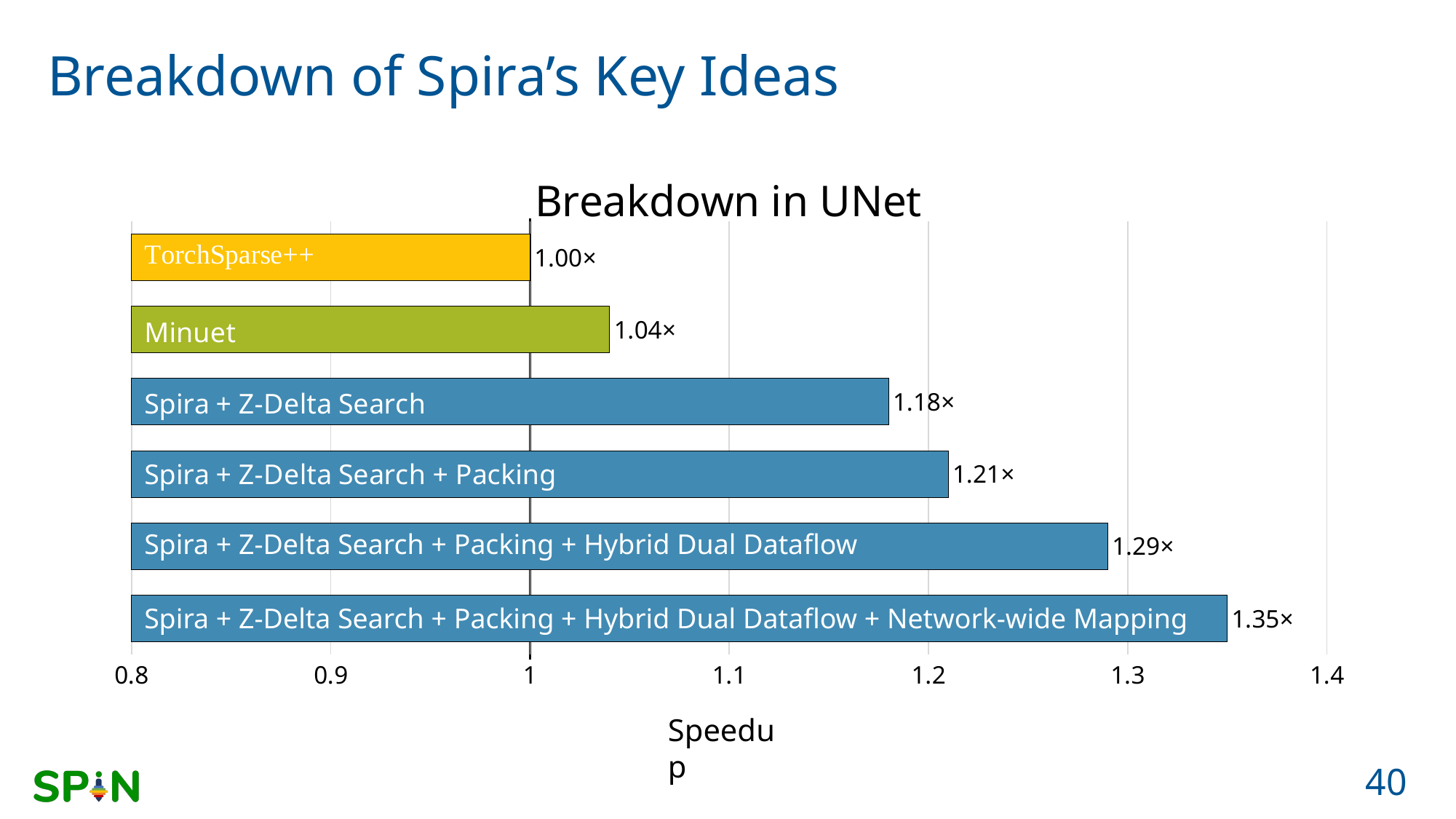
What is the speedup for Spira + Z-Delta Search + Packing + Hybrid Dual Dataflow + Network-wide Mapping? 1.35× Which has a larger speedup, Minuet or Spira + Z-Delta Search? Spira + Z-Delta Search Is the speedup for Spira + Z-Delta Search + Packing + Hybrid Dual Dataflow greater or less than 1.2? greater What is the speedup for Spira + Z-Delta Search + Packing? 1.21× What is the difference in speedup between Spira + Z-Delta Search + Packing + Hybrid Dual Dataflow and Spira + Z-Delta Search? 0.11× What kind of chart is shown on the slide? Bar chart What is the speedup for Minuet? 1.04× Which configuration has the highest speedup? Spira + Z-Delta Search + Packing + Hybrid Dual Dataflow + Network-wide Mapping What is the label of the horizontal axis? Speedup What is the title of the chart? Breakdown in UNet How many configurations are shown in the chart? 6 Which configuration has the lowest speedup? TorchSparse++